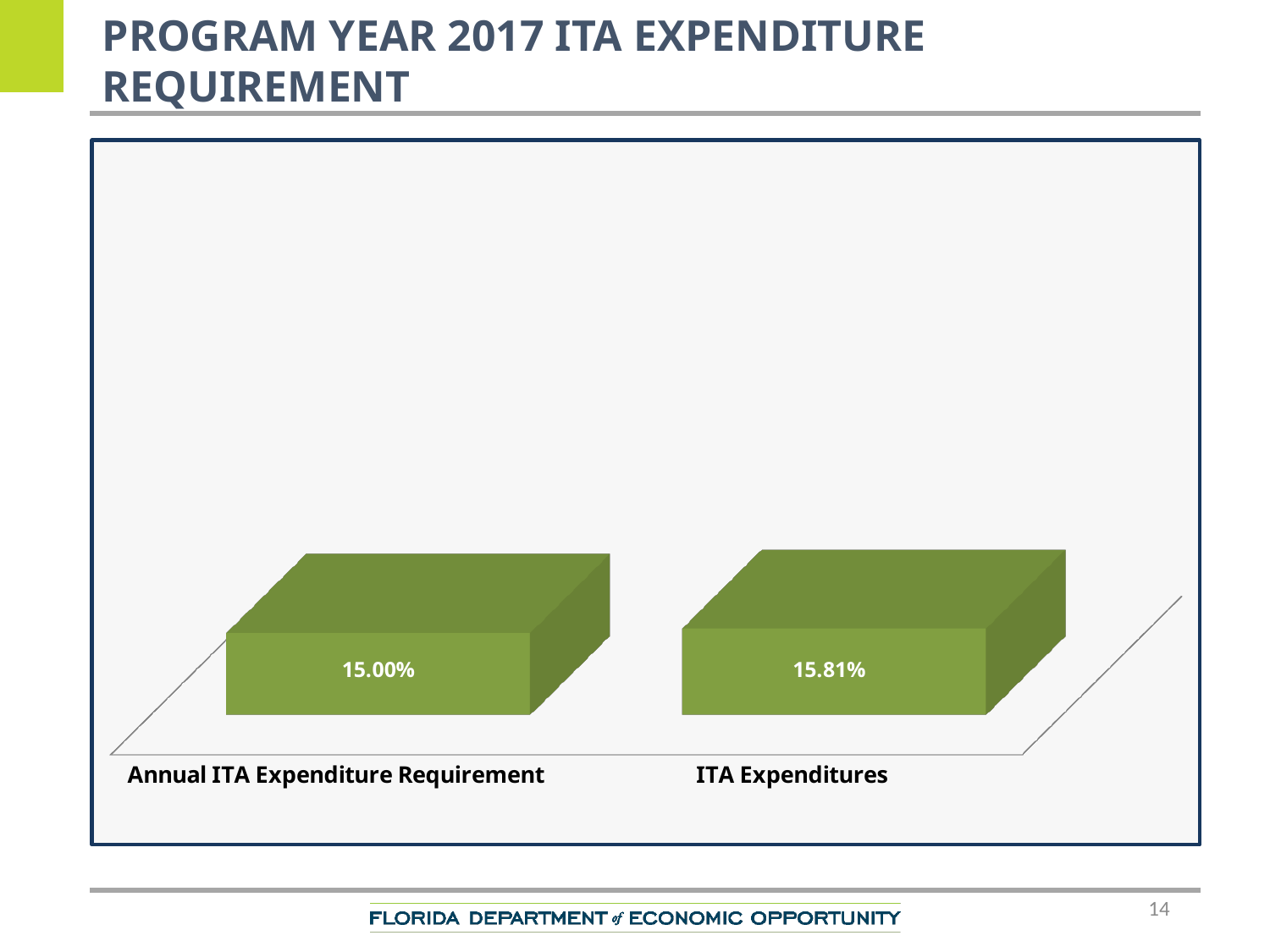
What is the difference between the ITA Expenditures value and the Annual ITA Expenditure Requirement value? 0.81% What is the title of the slide containing the chart? PROGRAM YEAR 2017 ITA EXPENDITURE REQUIREMENT What is the value for ITA Expenditures? 15.81% Which category has the higher value? ITA Expenditures How many categories are shown in the chart? 2 Is the value for ITA Expenditures larger or smaller than the value for Annual ITA Expenditure Requirement? larger What is the value for Annual ITA Expenditure Requirement? 15.00% What kind of chart is shown on the slide? bar chart Which category has the lower value? Annual ITA Expenditure Requirement What colour are the bars in the chart? green